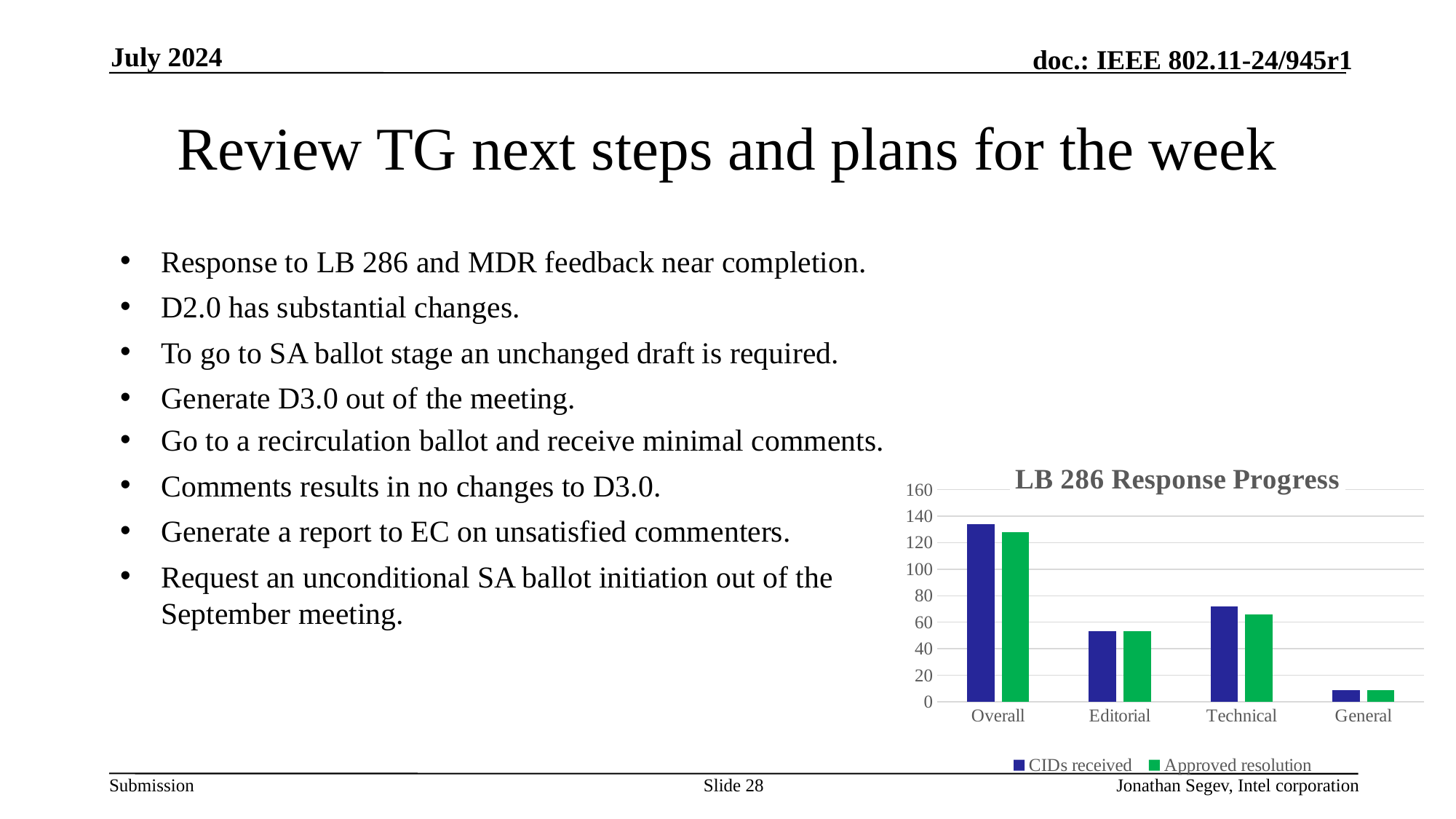
Is the value for Approved resolution in the Technical category greater or less than 60? greater Which colour represents the Approved resolution series in the chart? green Which is larger: CIDs received for Technical or CIDs received for Editorial? Technical How many categories are shown on the x axis of the chart? 4 How many series does the chart's legend list? 2 Which category has the highest value for CIDs received? Overall Is the value for CIDs received in the Editorial category greater or less than 60? less What is the title of the chart? LB 286 Response Progress Is the value for CIDs received in the General category greater or less than 20? less What kind of chart is shown on the slide? bar chart Which category has the lowest value for Approved resolution? General